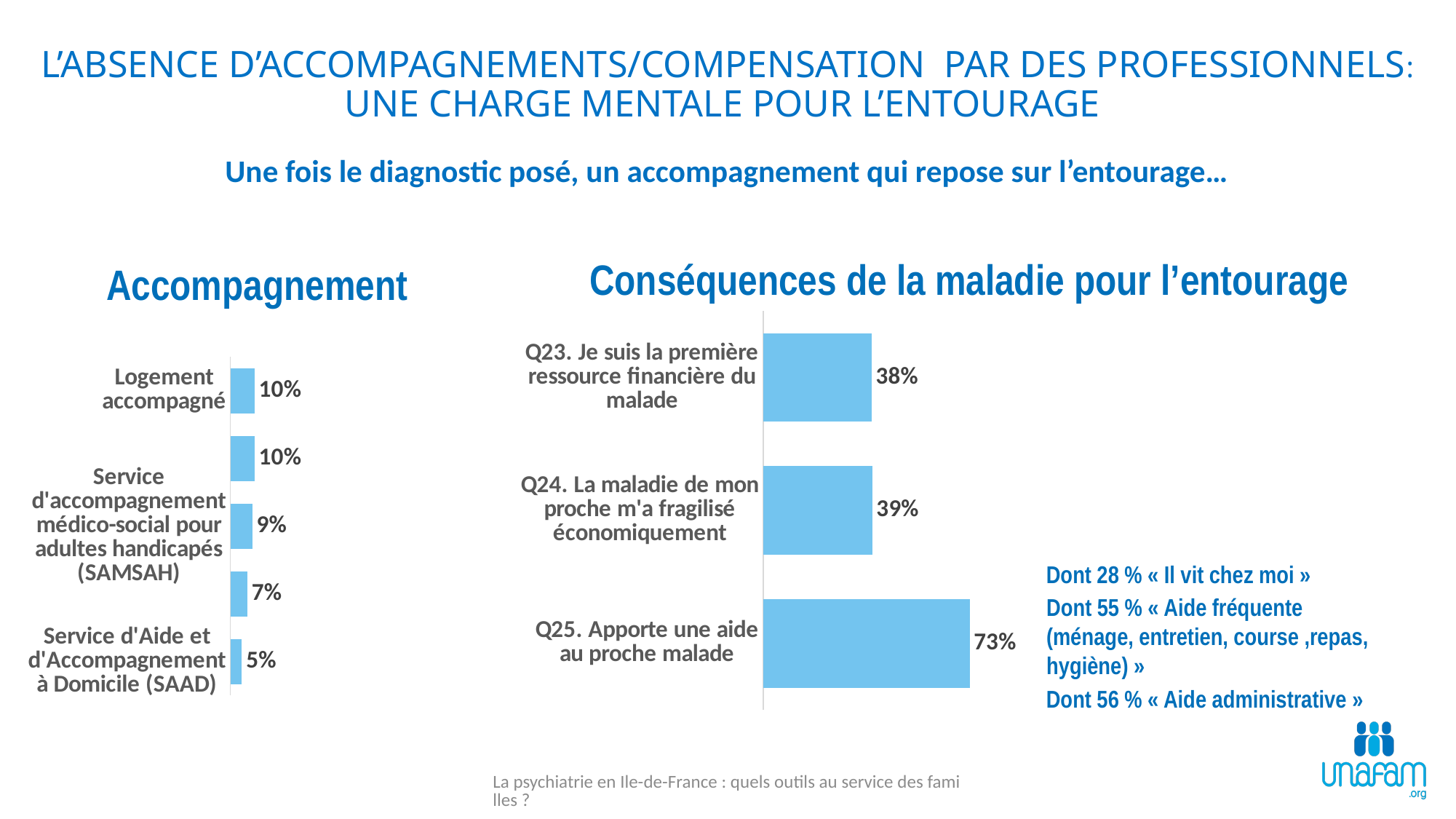
In the 'Conséquences de la maladie pour l'entourage' chart, what is the value for Q23 (Je suis la première ressource financière du malade)? 38% In the 'Conséquences de la maladie pour l'entourage' chart, which category has the highest value? Q25. Apporte une aide au proche malade In the 'Conséquences de la maladie pour l'entourage' chart, which category has the lowest value? Q23. Je suis la première ressource financière du malade In the 'Accompagnement' chart, how many bars are plotted? 5 In the 'Conséquences de la maladie pour l'entourage' chart, what is the value for Q25 (Apporte une aide au proche malade)? 73% In the 'Conséquences de la maladie pour l'entourage' chart, what is the difference between the values for Q25 and Q24? 34% In the 'Conséquences de la maladie pour l'entourage' chart, what is the value for Q24 (La maladie de mon proche m'a fragilisé économiquement)? 39% In the 'Accompagnement' chart, what is the value for Logement accompagné? 10% In the 'Accompagnement' chart, which is larger: the value for Logement accompagné or the value for SAAD? Logement accompagné What kind of chart is the 'Conséquences de la maladie pour l'entourage' chart? Bar chart In the 'Accompagnement' chart, what is the value for Service d'Aide et d'Accompagnement à Domicile (SAAD)? 5% In the 'Conséquences de la maladie pour l'entourage' chart, how many categories are plotted? 3